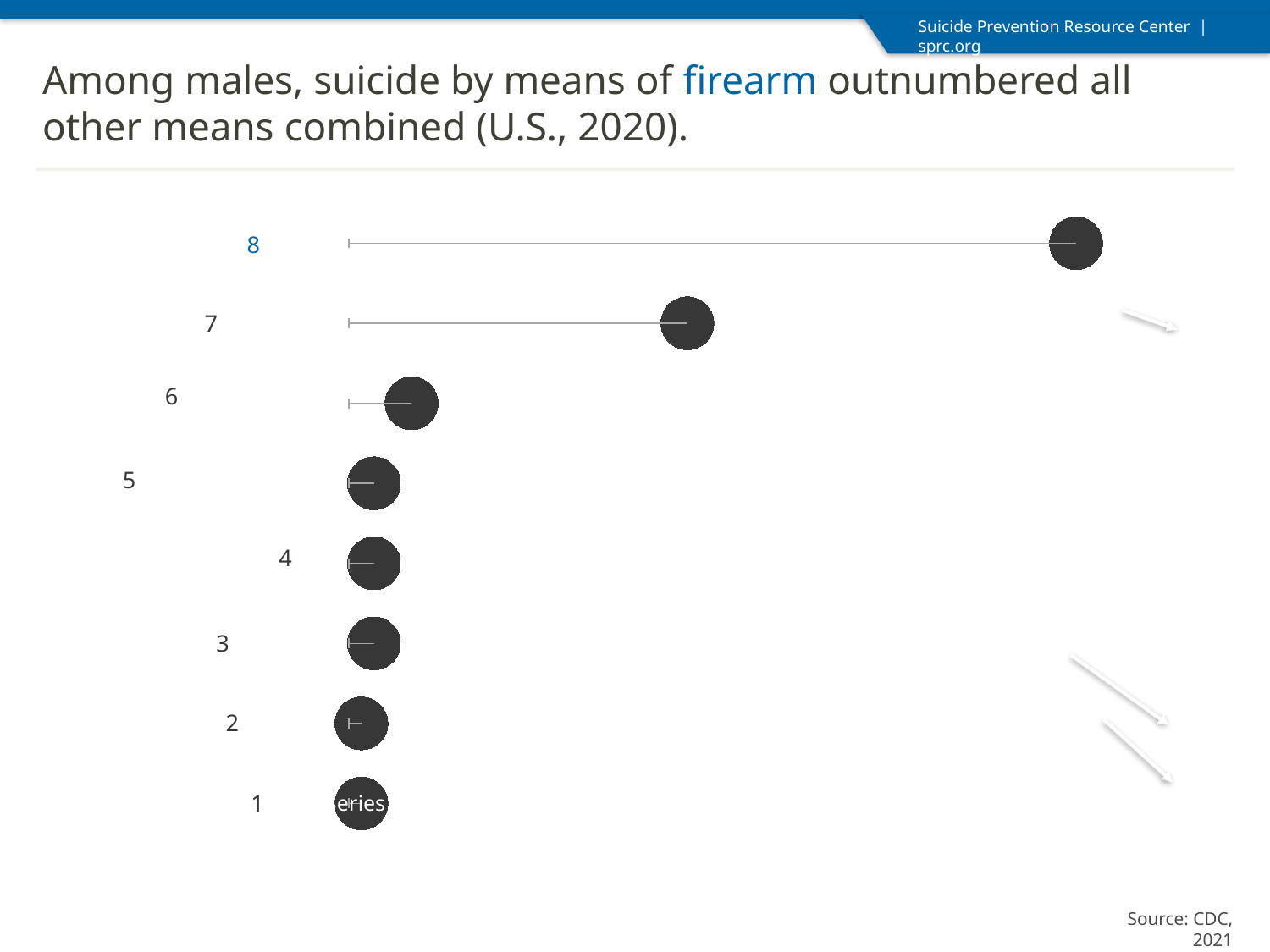
Which is larger, the value for category 8 or the value for category 6? 8 How many categories are plotted on the chart? 8 Which is larger, the value for category 7 or the value for category 6? 7 Which is larger, the value for category 6 or the value for category 5? 6 According to the slide title, which means of suicide among males outnumbered all other means combined in the U.S. in 2020? firearm Which category has the highest value on the chart? 8 Do the values rise or fall going from category 8 at the top to category 1 at the bottom? fall Which category label on the chart is shown in blue rather than black? 8